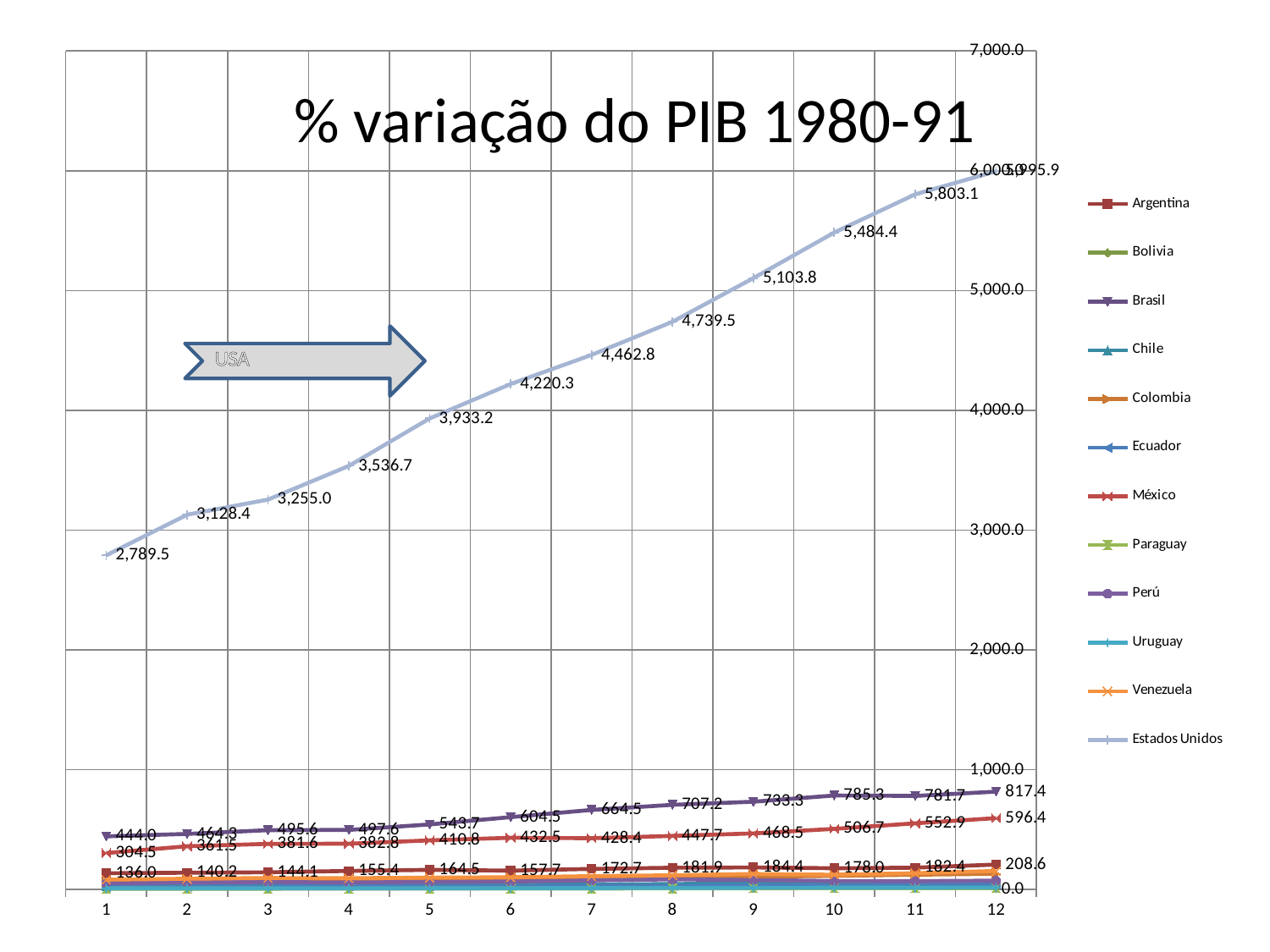
What is the value for México at point 12? 596.4 How many points are plotted along the x axis for each series? 12 What is the title of the chart? % variação do PIB 1980-91 What is the value for Estados Unidos at point 1? 2,789.5 What kind of chart is shown on the slide? line chart Does the Estados Unidos line rise or fall from point 1 to point 12? rise How many series does the legend list? 12 What is the value for Estados Unidos at point 11? 5,803.1 What is the value for Brasil at point 12? 817.4 What is the difference between the Estados Unidos values at point 2 and point 1? 338.9 At point 12, which is larger: Brasil or México? Brasil Which series has the highest value at point 12? Estados Unidos